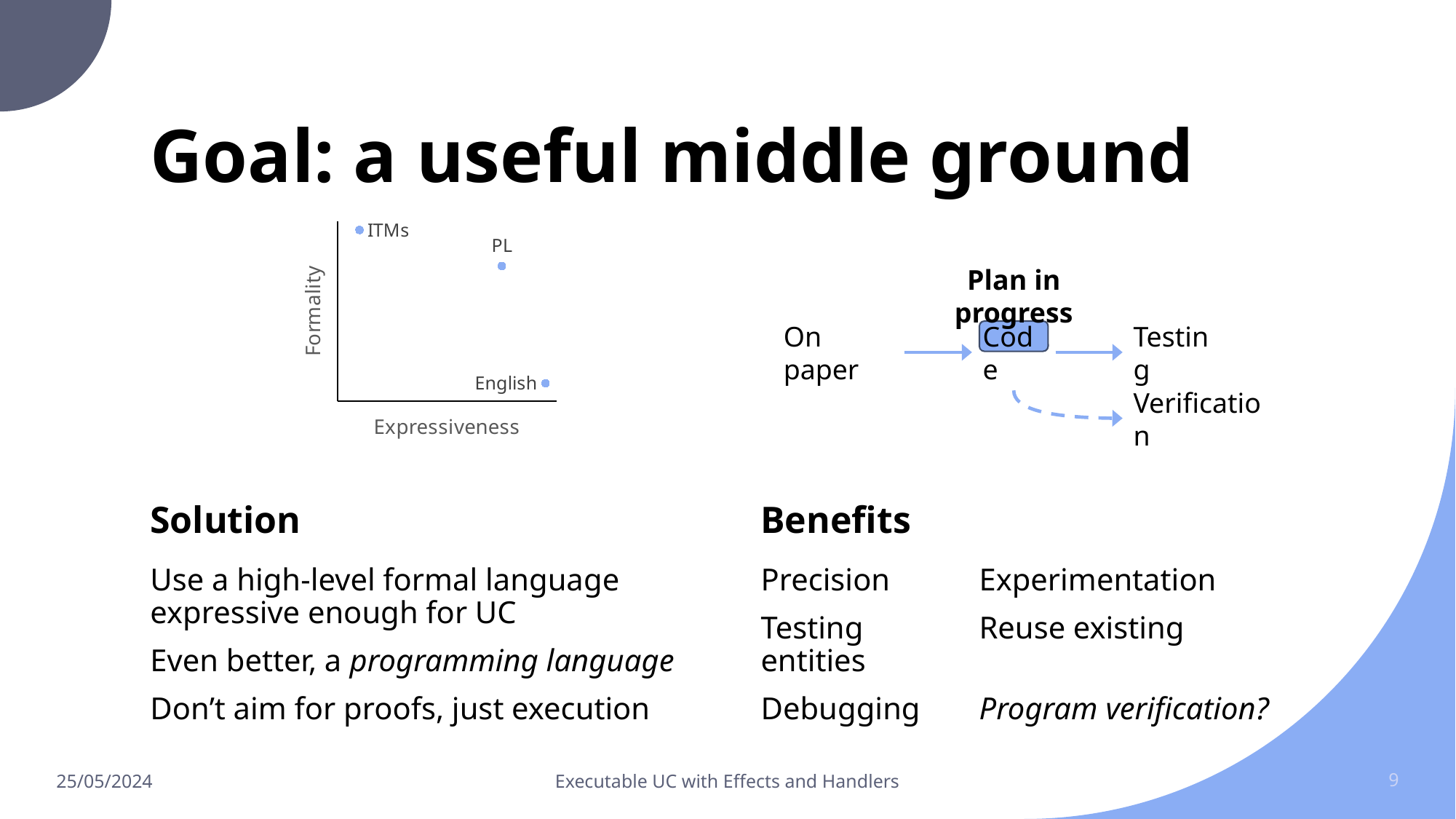
Which point in the scatter chart has the lowest expressiveness? ITMs In the scatter chart, which is more expressive, ITMs or PL? PL What is the label of the vertical axis of the scatter chart? Formality Which point in the scatter chart has the highest expressiveness? English In the scatter chart, which is more formal, ITMs or PL? ITMs In the scatter chart, which is more formal, PL or English? PL Which point in the scatter chart has the highest formality? ITMs What is the label of the horizontal axis of the scatter chart? Expressiveness Which point in the scatter chart has the lowest formality? English How many data points are plotted in the scatter chart? 3 What kind of chart is shown on the left of the slide? scatter chart